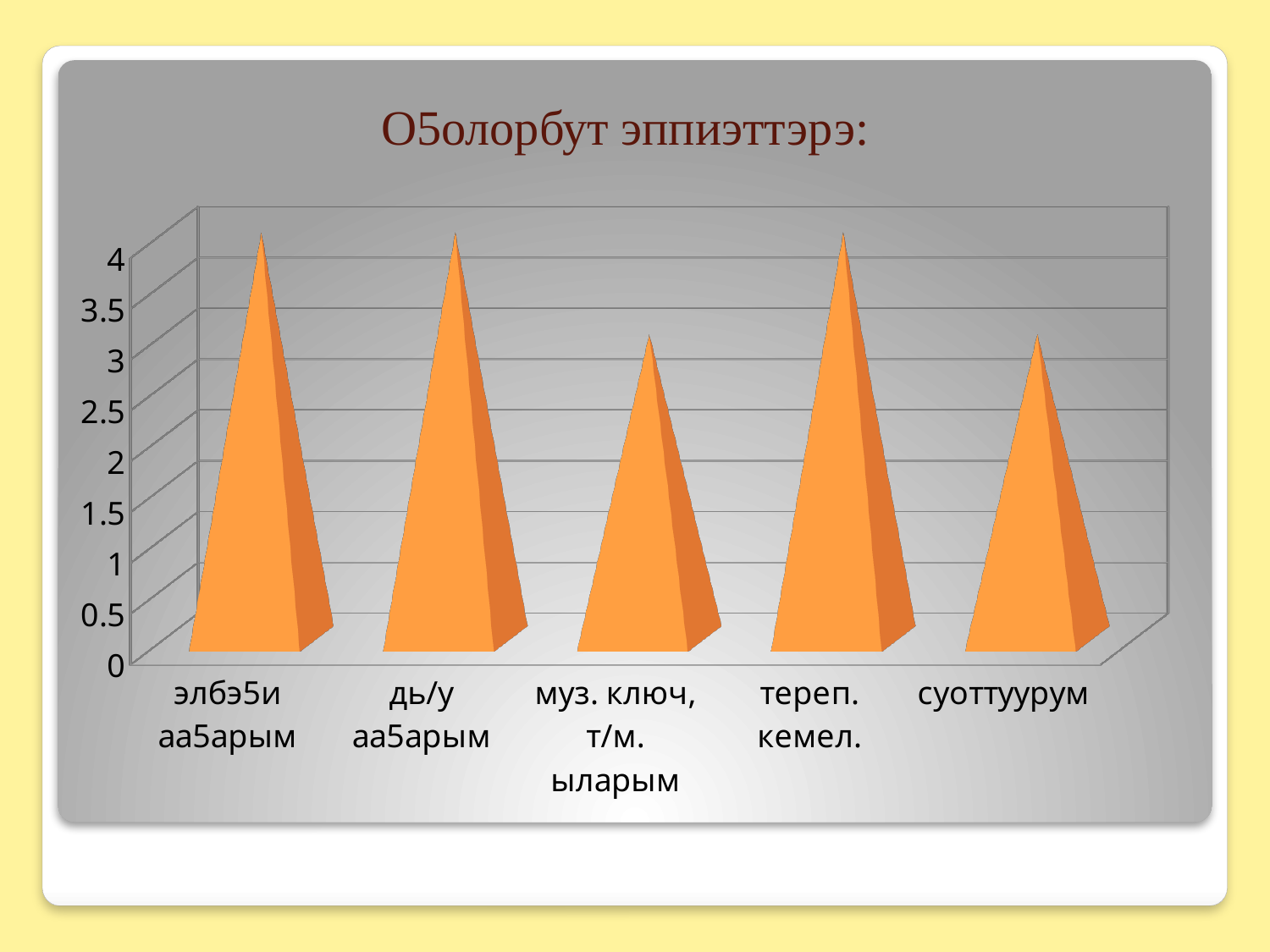
Is the value for элбэ5и аа5арым greater or less than 3.5? greater How many categories are shown on the x axis of the chart? 5 Is the value for дь/у аа5арым greater or less than 3? greater Is the value for тереп. кемел. greater or less than 3.5? greater What kind of chart is shown on the slide? bar chart Which is larger, the value for суоттуурум or the value for тереп. кемел.? тереп. кемел. Which is larger, the value for элбэ5и аа5арым or the value for муз. ключ, т/м. ыларым? элбэ5и аа5арым What colour are the bars in the chart? orange What is the title of the chart? О5олорбут эппиэттэрэ: